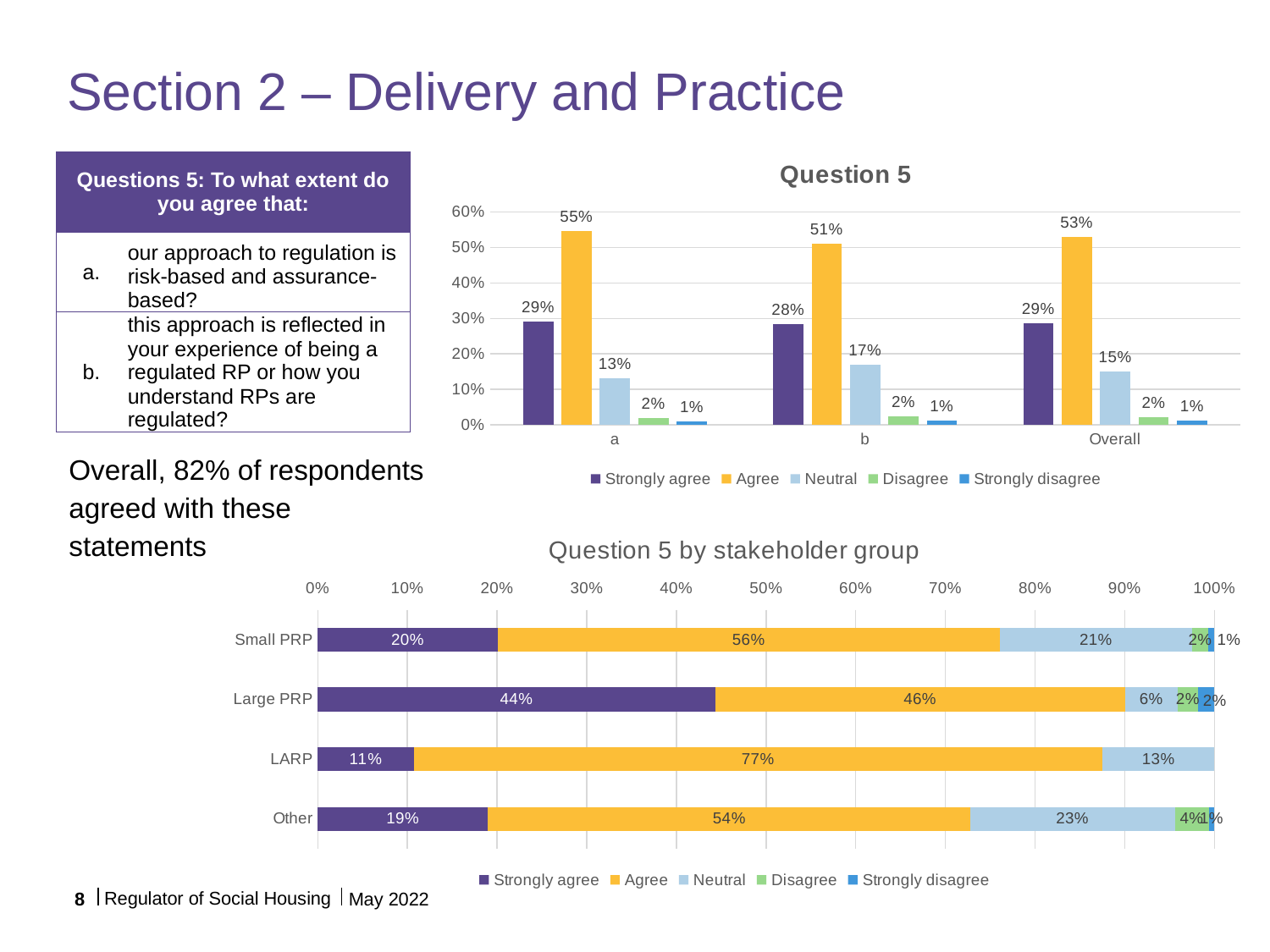
In the 'Question 5' chart, what is the difference between the Agree values for a and b? 4 percentage points In the 'Question 5 by stakeholder group' chart, which has the larger Neutral value, Small PRP or Other? Other How many stakeholder groups are shown in the 'Question 5 by stakeholder group' chart? 4 In the 'Question 5 by stakeholder group' chart, what is the Strongly agree value for Small PRP? 20% In the 'Question 5' chart, what is the value for Neutral in category b? 17% In the 'Question 5 by stakeholder group' chart, what is the Agree value for LARP? 77% What is the title of the lower chart on the slide? Question 5 by stakeholder group In the 'Question 5' chart, which category has the highest Agree value? a In the 'Question 5 by stakeholder group' chart, which group has the highest Strongly agree value? Large PRP What kind of chart is the 'Question 5' chart? Bar chart How many series does the legend of the 'Question 5' chart list? 5 In the 'Question 5' chart, what is the value for Agree in category a? 55%